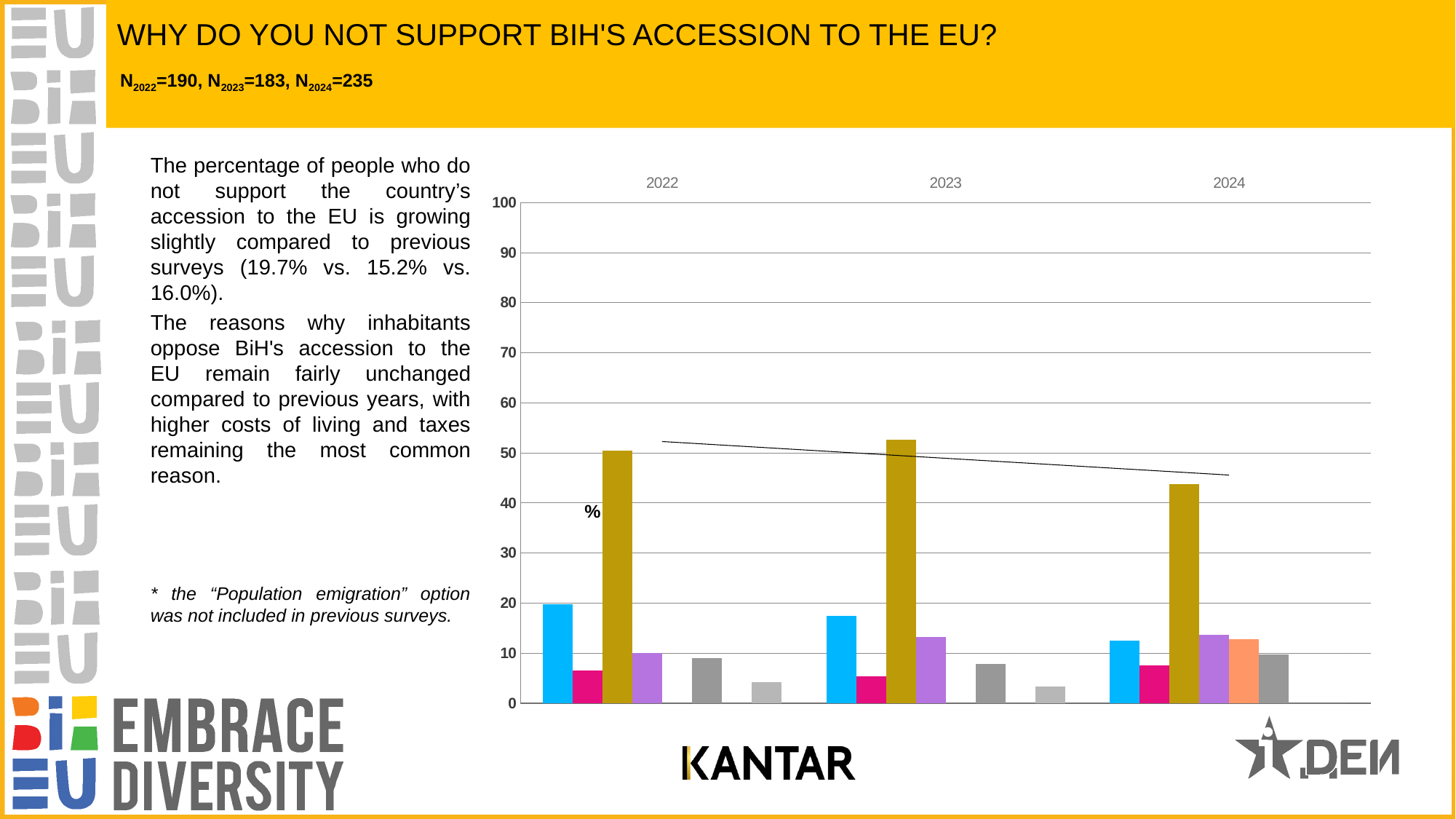
What is the maximum value shown on the chart's vertical axis? 100 Does the tallest (gold) bar rise or fall from 2023 to 2024? fall Is the value of the tallest (gold) bar for 2024 greater or less than 50? less How many survey years are shown along the x axis of the chart? 3 Which survey years are shown on the x axis of the chart? 2022, 2023, 2024 Which is larger: the first (blue) bar for 2022 or the first (blue) bar for 2024? 2022 Is the value of the first (blue) bar for 2023 greater or less than 20? less Which is larger: the tallest (gold) bar for 2023 or the tallest (gold) bar for 2024? 2023 Is the value of the tallest (gold) bar for 2023 greater or less than 50? greater In which year does the tallest bar of the chart reach its highest value? 2023 What kind of chart is shown on the slide? bar chart